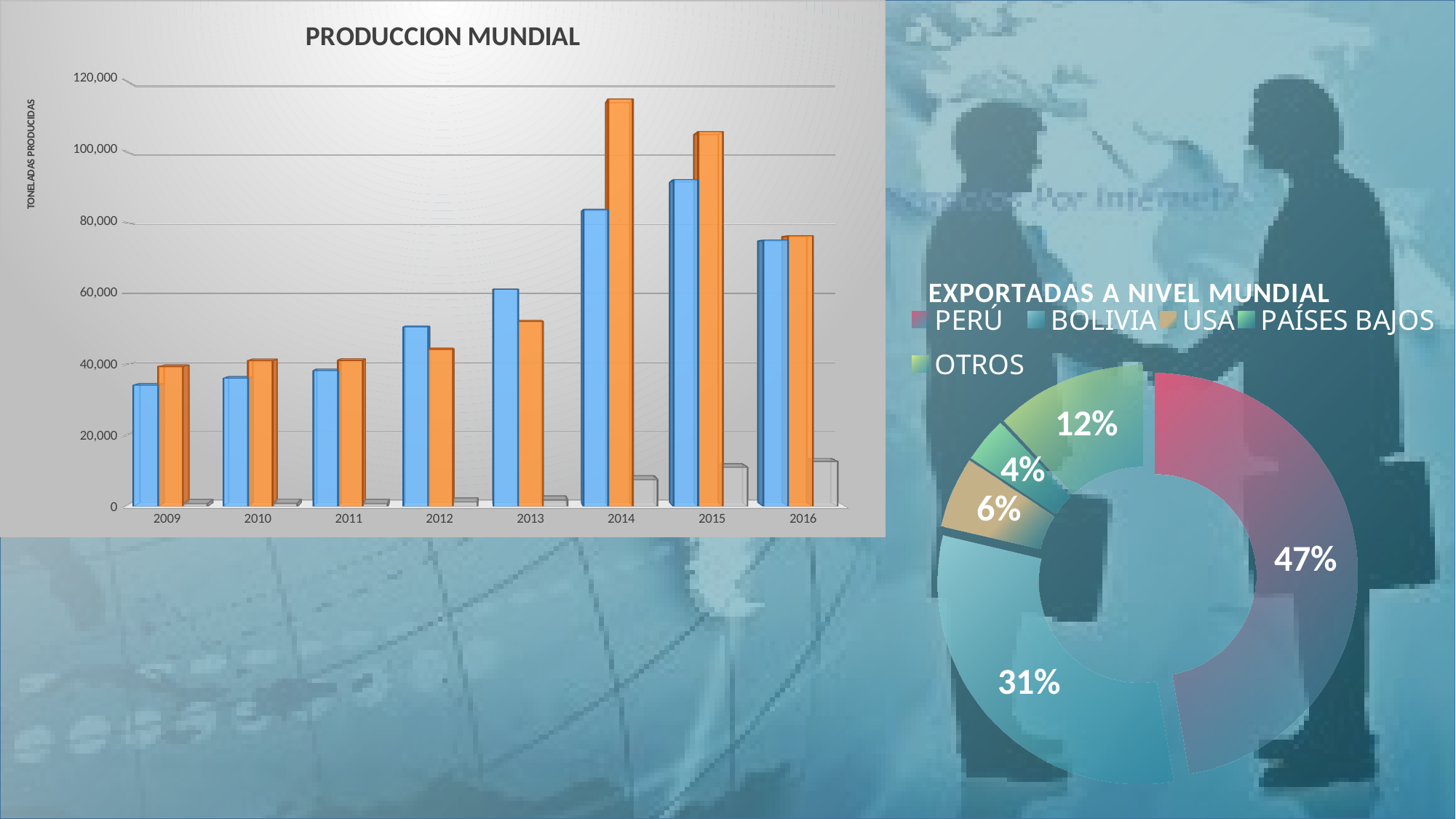
In the PRODUCCION MUNDIAL chart, is the value of the orange bar for 2014 greater or less than 100,000? greater In the PRODUCCION MUNDIAL chart, is the value of the blue bar for 2015 greater or less than 80,000? greater In the EXPORTADAS A NIVEL MUNDIAL chart, what share does BOLIVIA have? 31% In the PRODUCCION MUNDIAL chart, what is the label on the vertical axis? TONELADAS PRODUCIDAS In the PRODUCCION MUNDIAL chart, is the value of the blue bar for 2009 greater or less than 40,000? less In the PRODUCCION MUNDIAL chart, what kind of chart is shown? bar chart In the PRODUCCION MUNDIAL chart, how many years are shown on the x axis? 8 In the EXPORTADAS A NIVEL MUNDIAL chart, what share does PERÚ have? 47% In the EXPORTADAS A NIVEL MUNDIAL chart, how many categories does the legend list? 5 In the PRODUCCION MUNDIAL chart, which is larger in 2013, the blue bar or the orange bar? the blue bar In the PRODUCCION MUNDIAL chart, in which year is the orange bar the tallest? 2014 In the EXPORTADAS A NIVEL MUNDIAL chart, which category has the smallest share? PAÍSES BAJOS